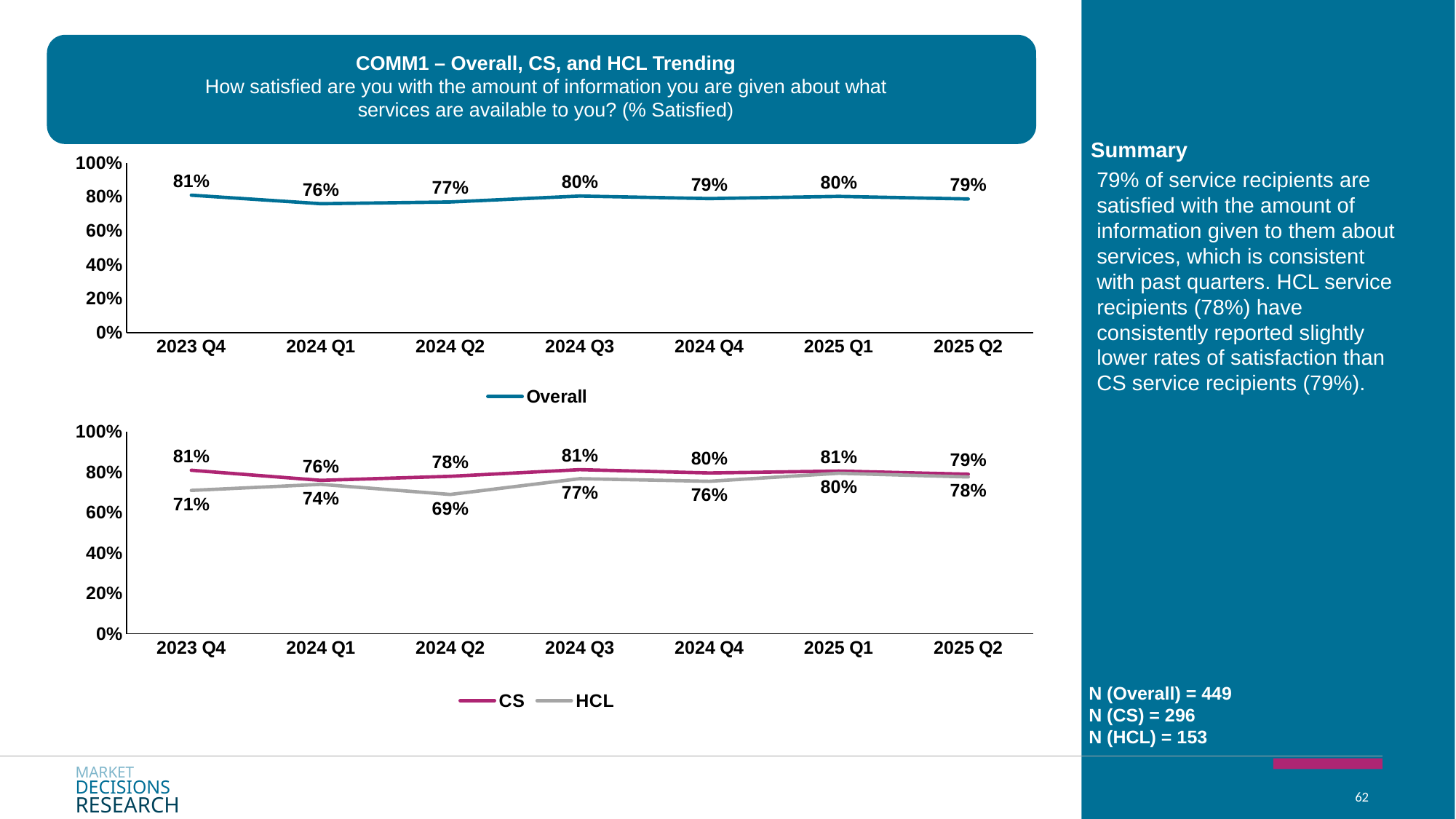
In the bottom chart, what is the CS value for 2025 Q1? 81% In the top chart (Overall), what is the difference between the 2023 Q4 value and the 2024 Q1 value? 5% In the top chart (Overall), what is the value for 2023 Q4? 81% In the bottom chart, is the HCL value for 2024 Q2 greater or less than 80%? less In the bottom chart, which is larger in 2023 Q4, the CS value or the HCL value? CS In the top chart (Overall), which quarter has the lowest value? 2024 Q1 In the bottom chart, what is the HCL value for 2024 Q2? 69% In the top chart (Overall), how many quarters are plotted on the x axis? 7 In the bottom chart, which quarter has the lowest HCL value? 2024 Q2 In the bottom chart, what is the difference between the CS and HCL values in 2023 Q4? 10% In the bottom chart, how many series does the legend list? 2 What type of chart is the top chart? Line chart